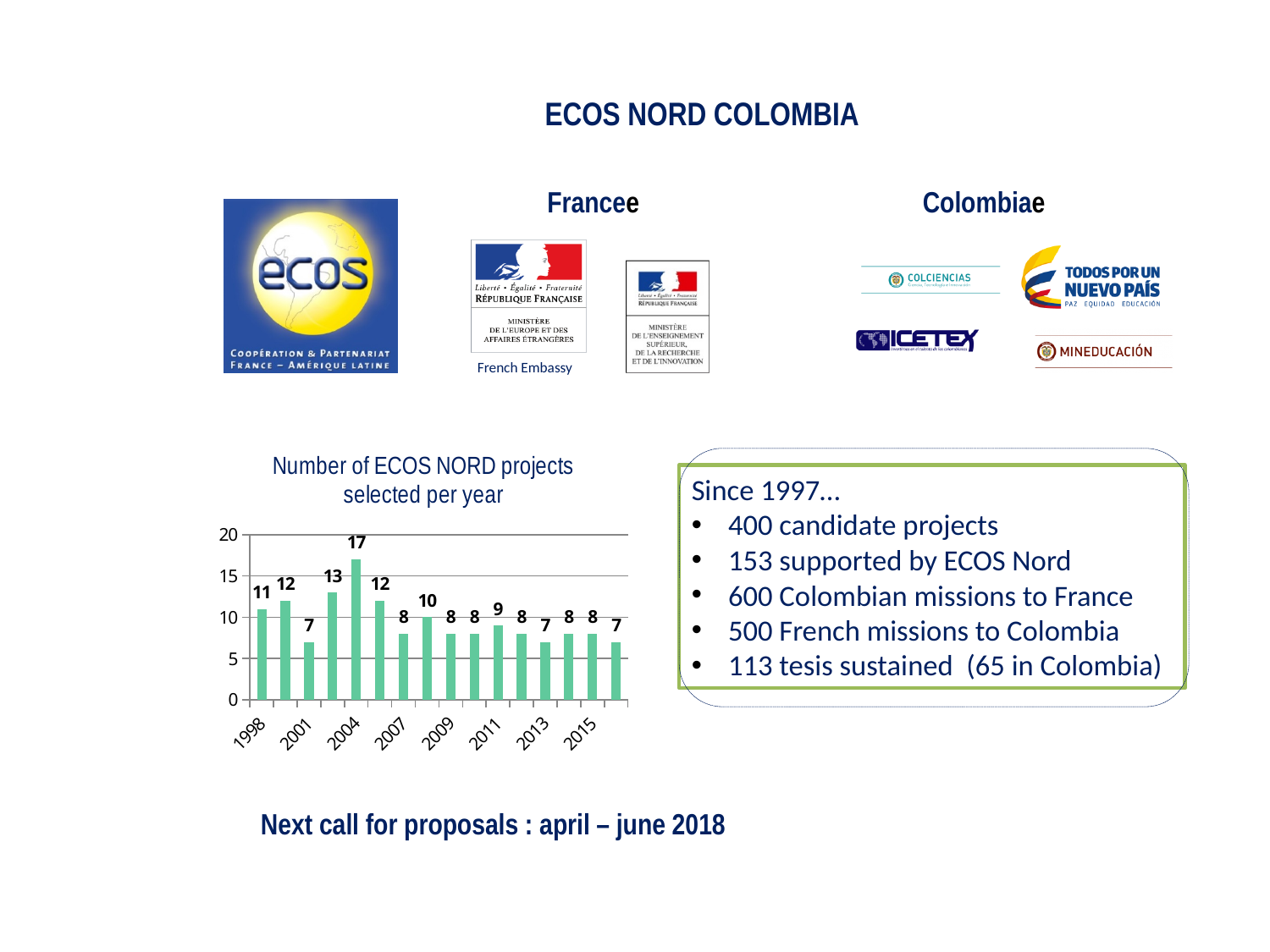
How many projects were selected in 1998, the first year on the chart? 11 How many projects were selected in 2004, the year with the tallest bar? 17 Is the value of the tallest bar on the chart greater or less than 15? greater What is the difference between the highest and lowest yearly values on the chart? 10 What is the lowest number of ECOS NORD projects selected in a single year shown on the chart? 7 What is the title of the chart on the slide? Number of ECOS NORD projects selected per year How many bars on the chart have a value of exactly 8? 6 After the peak of 17, do the yearly values generally rise or fall toward the right of the chart? fall What kind of chart is used to show the number of ECOS NORD projects selected per year? bar chart How many bars (years) are plotted on the chart? 16 Which is larger: the value of the first bar (1998) or the second bar? the second bar (12) What is the highest number of ECOS NORD projects selected in a single year shown on the chart? 17